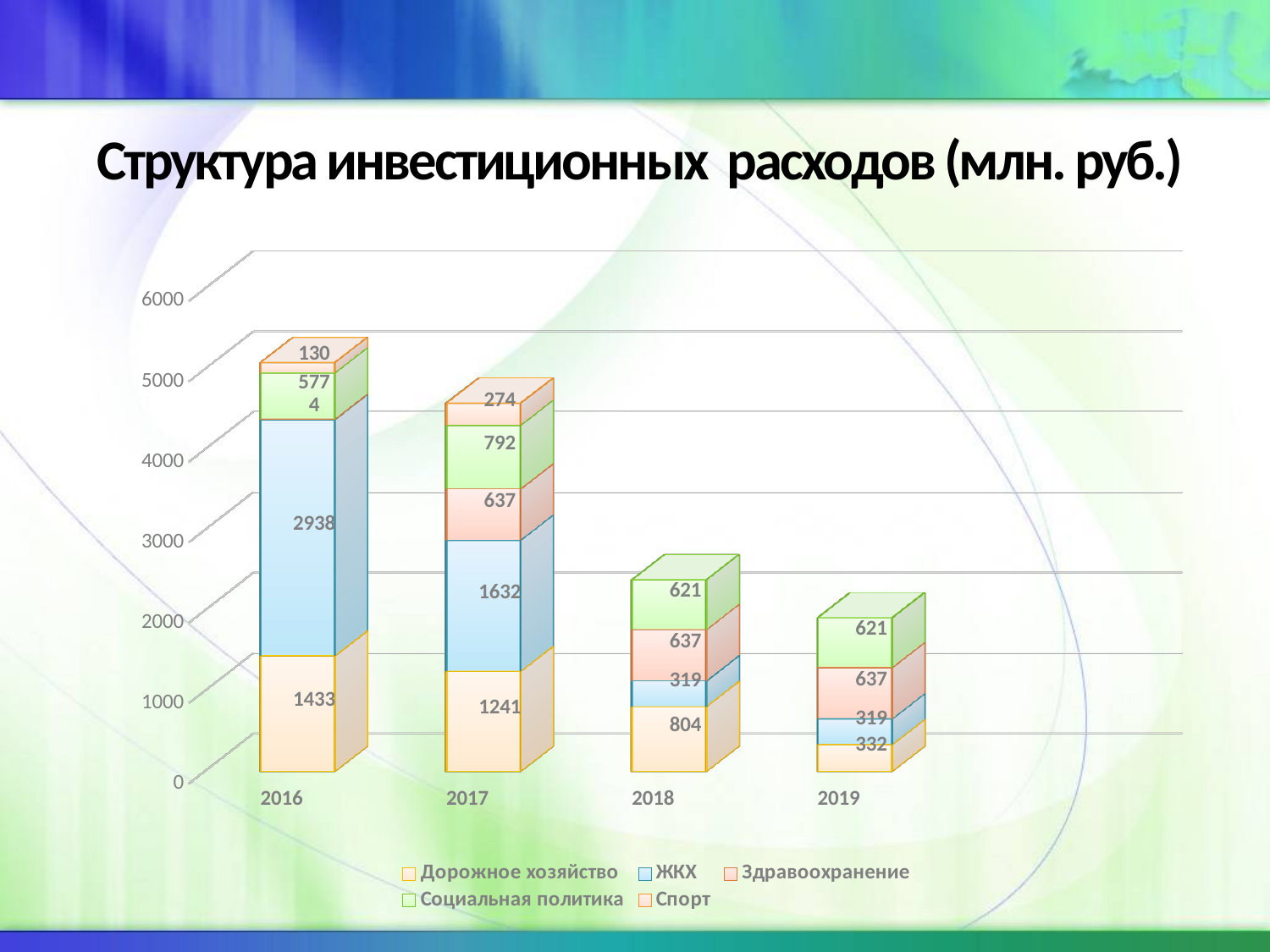
What is the value for ЖКХ in 2017? 1632 What is the difference between the Дорожное хозяйство values in 2016 and 2017? 192 Do the total bar heights rise or fall from 2016 to 2019? fall What is the value for Дорожное хозяйство in 2016? 1433 What is the value for Социальная политика in 2018? 621 Which is larger: ЖКХ in 2016 or ЖКХ in 2017? ЖКХ in 2016 In which year is the Дорожное хозяйство value lowest? 2019 In which year is the ЖКХ value highest? 2016 What is the total of the stacked bar for 2018? 2381 What is the total of the stacked bar for 2019? 1909 How many series does the legend list? 5 What is the value for Спорт in 2017? 274